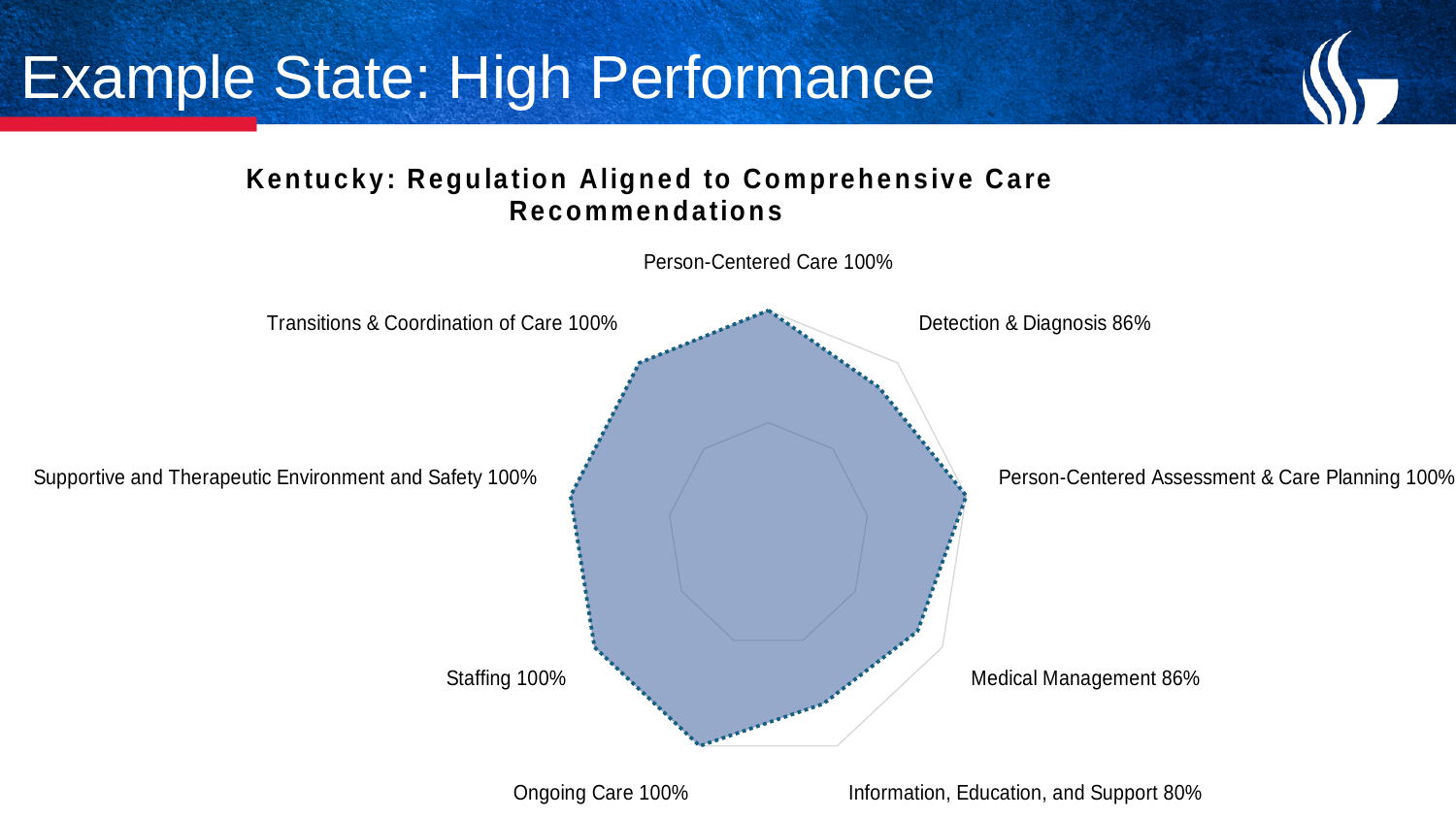
What is the value for Staffing? 100% What is the value for Person-Centered Assessment & Care Planning? 100% What is the value for Medical Management? 86% What is the difference between the value for Ongoing Care and the value for Information, Education, and Support? 20% How many categories does the radar chart have? 9 Which category has the lowest value? Information, Education, and Support What is the title of the chart? Kentucky: Regulation Aligned to Comprehensive Care Recommendations What is the value for Information, Education, and Support? 80% What is the difference between the value for Medical Management and the value for Information, Education, and Support? 6% Which is larger, the value for Detection & Diagnosis or the value for Information, Education, and Support? Detection & Diagnosis What kind of chart is shown on the slide? Radar chart What is the value for Detection & Diagnosis? 86%